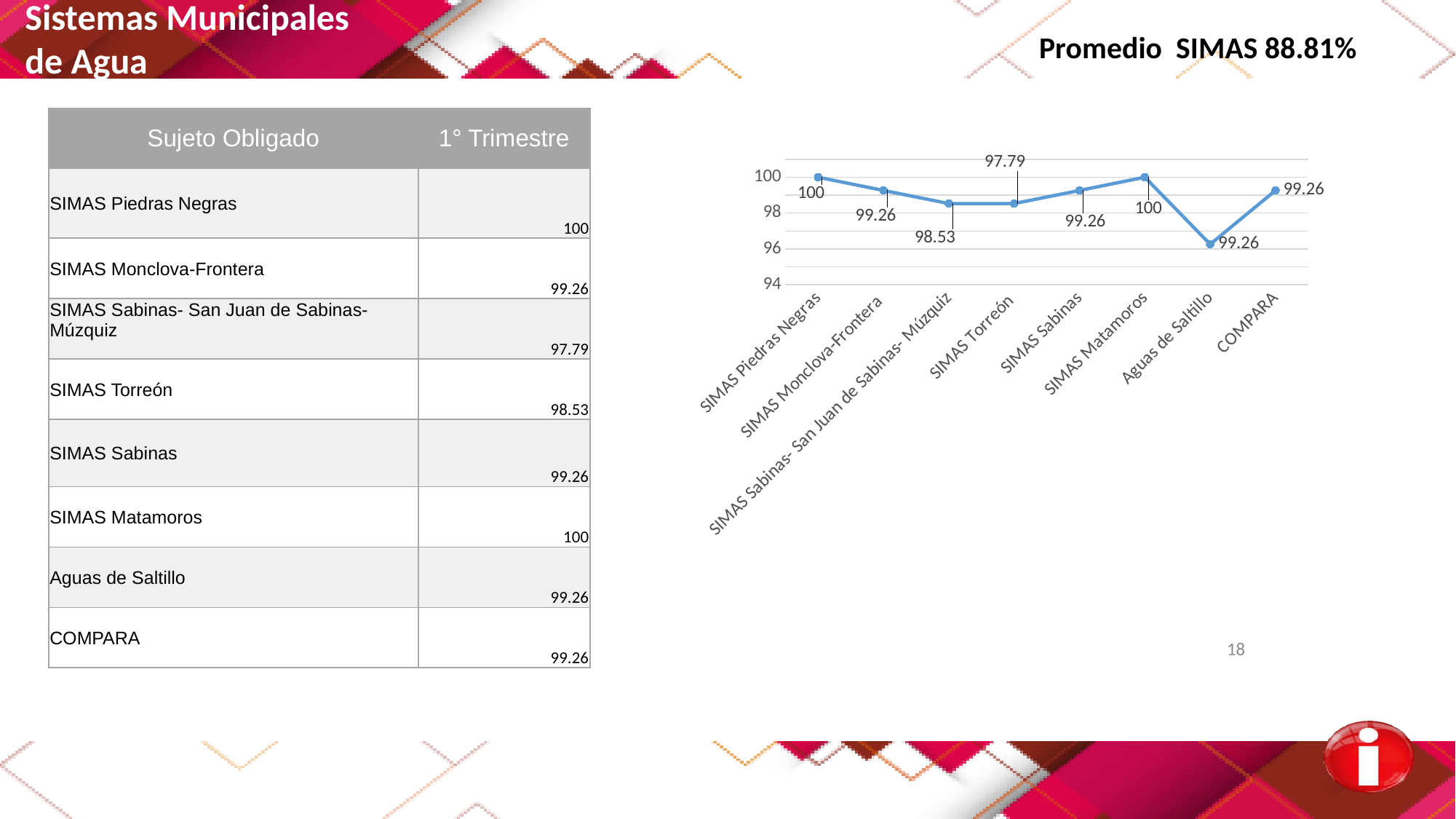
What is the value shown for COMPARA? 99.26 What is the lowest value shown on the chart's vertical axis? 94 How many categories are plotted on the x axis of the chart? 8 What kind of chart is shown on the slide? line chart Which is larger, the value for SIMAS Piedras Negras or the value for SIMAS Torreón? SIMAS Piedras Negras What is the value shown for SIMAS Matamoros? 100 What is the difference between the values for SIMAS Piedras Negras and SIMAS Sabinas- San Juan de Sabinas- Múzquiz? 2.21 What is the value shown for SIMAS Piedras Negras? 100 Does the line rise or fall from SIMAS Matamoros to Aguas de Saltillo? fall What is the value shown for SIMAS Sabinas- San Juan de Sabinas- Múzquiz? 97.79 Which categories have the highest value in the chart? SIMAS Piedras Negras and SIMAS Matamoros What is the value shown for SIMAS Torreón? 98.53